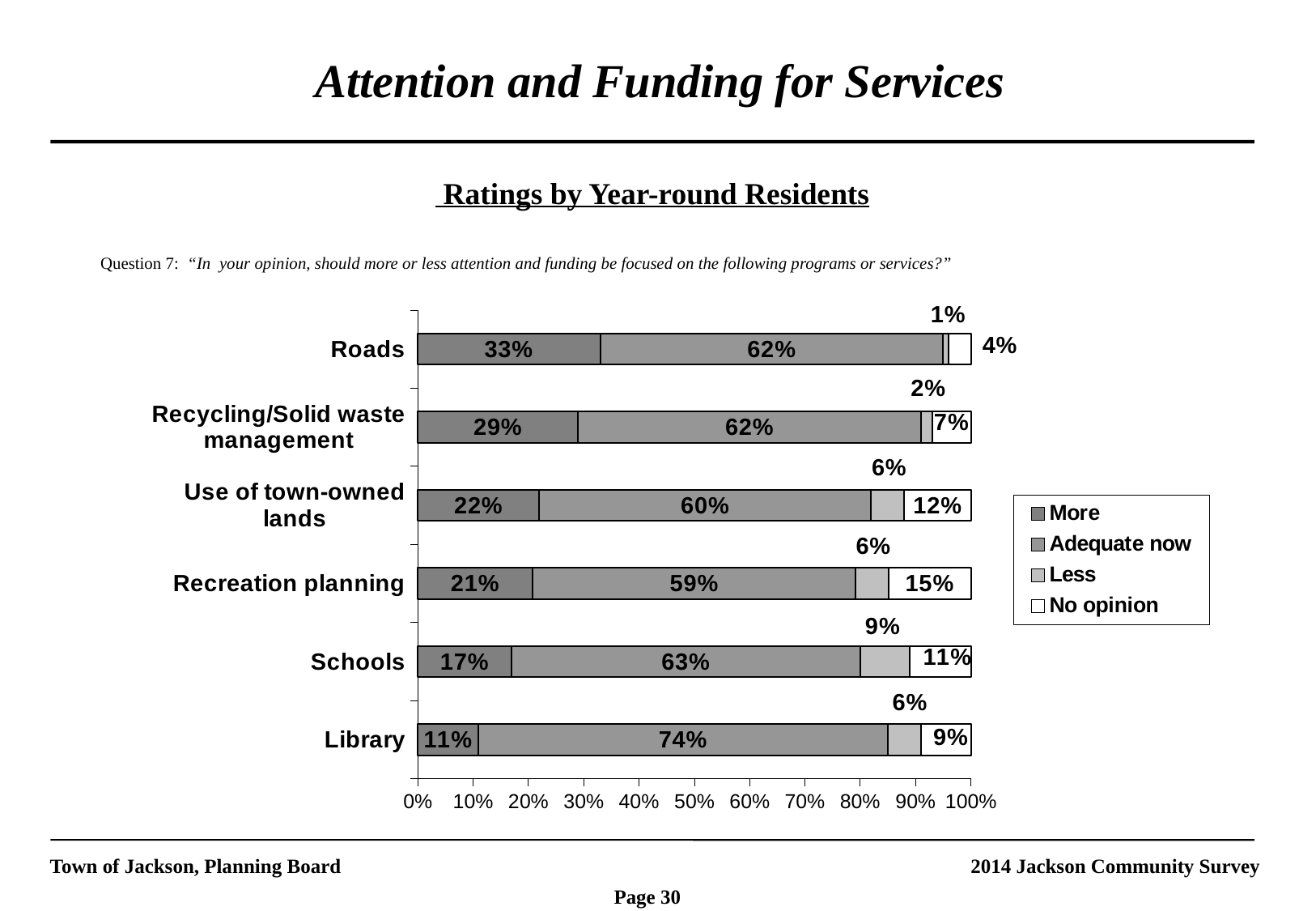
What percentage of year-round residents said "More" attention and funding should go to Roads? 33% What is the difference between the "More" values for Roads and Library? 22% What is the "Adequate now" value for Library? 74% Which service has the highest "More" percentage? Roads Which legend entry is shown in white? No opinion How many series does the legend list? 4 What kind of chart is shown on the slide? Stacked bar chart Which is larger, the "No opinion" value for Use of town-owned lands or for Schools? Use of town-owned lands What is the "No opinion" value for Recreation planning? 15% Which service has the lowest "More" percentage? Library What is the "Less" value for Schools? 9% How many services are shown on the chart? 6